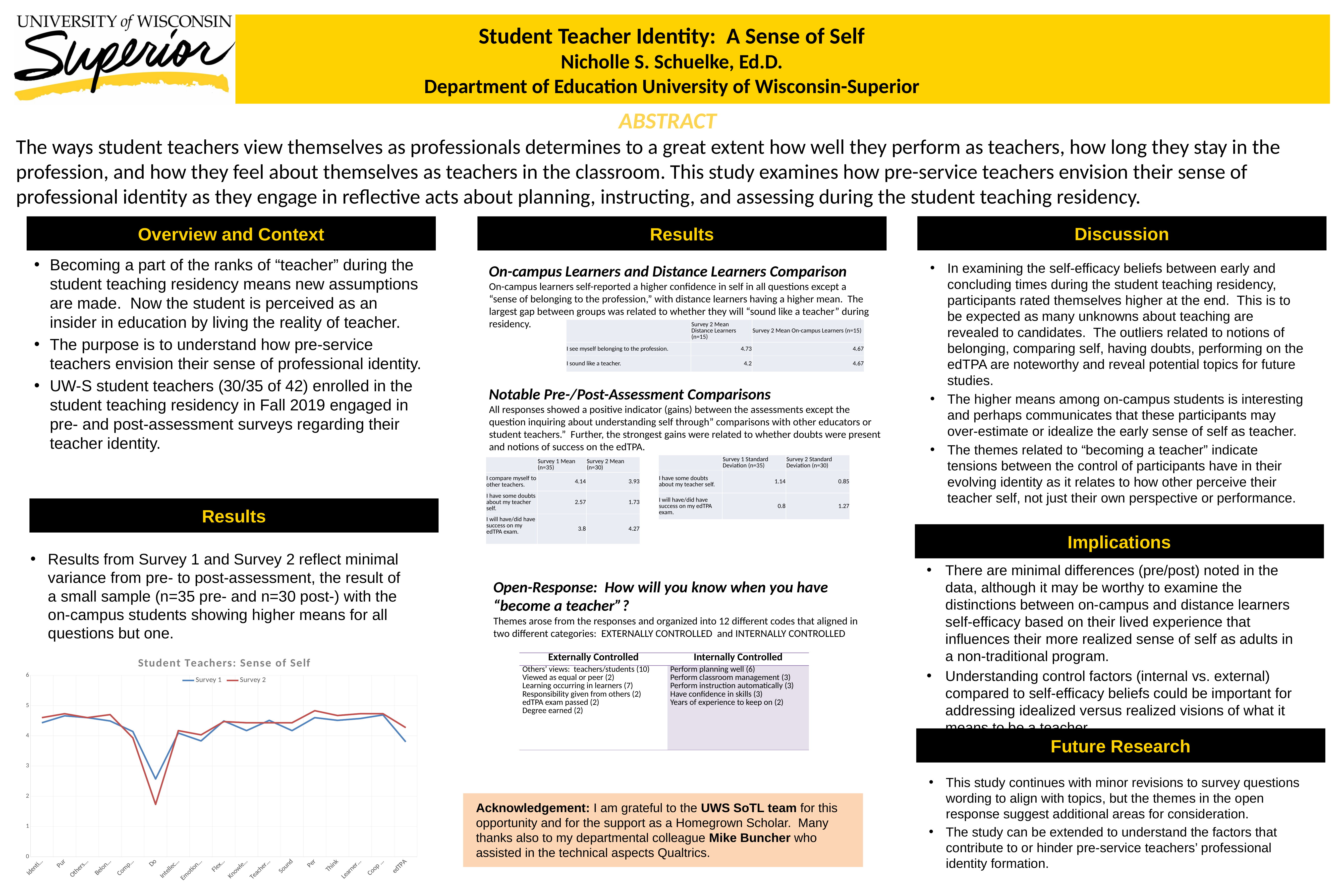
In the "Student Teachers: Sense of Self" chart, is the Survey 2 value for "Do" greater or less than 2? less In the "Student Teachers: Sense of Self" chart, is the Survey 1 value for "Do" greater or less than 2? greater In the "Student Teachers: Sense of Self" chart, which category has the lowest value for Survey 2? Do What are the two series named in the legend of the "Student Teachers: Sense of Self" chart? Survey 1 and Survey 2 In the "Student Teachers: Sense of Self" chart, is the Survey 1 value for "Pur" greater or less than 4? greater How many series does the legend of the "Student Teachers: Sense of Self" chart list? 2 How many categories are shown on the x axis of the "Student Teachers: Sense of Self" chart? 17 What colour is the Survey 2 line in the "Student Teachers: Sense of Self" chart? red In the "Student Teachers: Sense of Self" chart, at the category "Do", which series has the larger value, Survey 1 or Survey 2? Survey 1 In the "Student Teachers: Sense of Self" chart, which category has the lowest value for Survey 1? Do In the "Student Teachers: Sense of Self" chart, at the category "edTPA", which series has the larger value, Survey 1 or Survey 2? Survey 2 What kind of chart is "Student Teachers: Sense of Self"? line chart